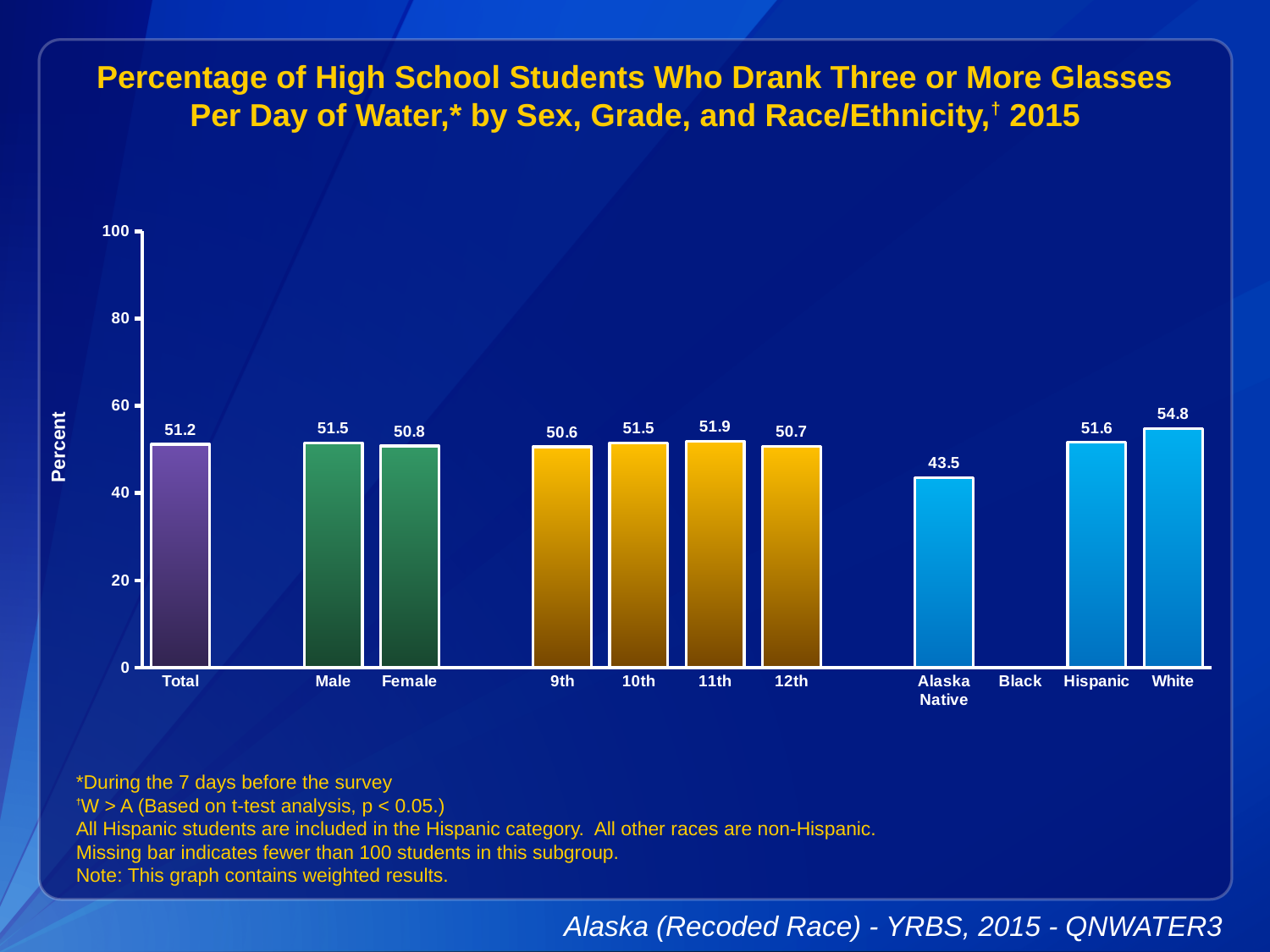
Which category has no bar shown? Black What is the difference between the values for White and Alaska Native? 11.3 Which is larger, the value for Hispanic or the value for Alaska Native? Hispanic Is the value for White greater or less than 60? less What kind of chart is shown? bar chart Which category has the highest value? White What is the value for Total? 51.2 Which category with a bar has the lowest value? Alaska Native What is the value for Alaska Native? 43.5 What is the value for 11th grade? 51.9 What is the difference between the values for Male and Female? 0.7 How many bars are plotted on the chart? 10